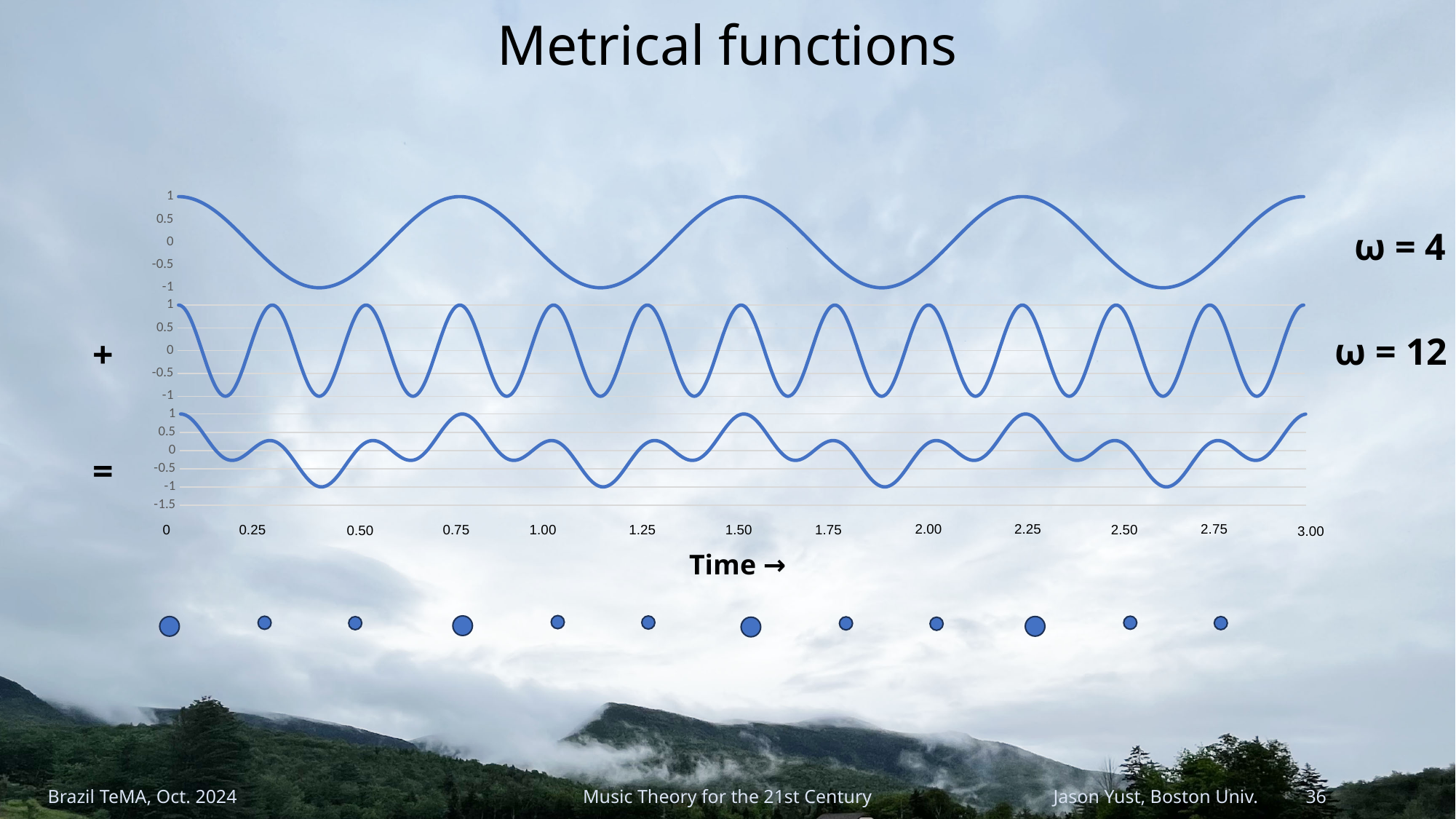
In the bottom (sum) plot, is the value at time 1.50 greater or less than 0.5? greater What is the label on the x axis of the plots? Time → What ω value is labelled next to the top wave plot? ω = 4 How many tick labels are shown on the shared x axis from 0 to 3.00? 13 In the middle plot (ω = 12), how many peaks are there between time 0 and 3.00 inclusive? 13 In the top plot (ω = 4), what is the value at time 0? 1 How many separate wave plots are stacked on the slide? 3 What kind of chart is used for the three plots on the slide? line chart What is the lowest y-axis tick shown on the bottom (sum) plot? -1.5 In the middle plot (ω = 12), what is the value at time 0.25? 1 In the top plot (ω = 4), does the value rise or fall between time 0 and 0.25? fall